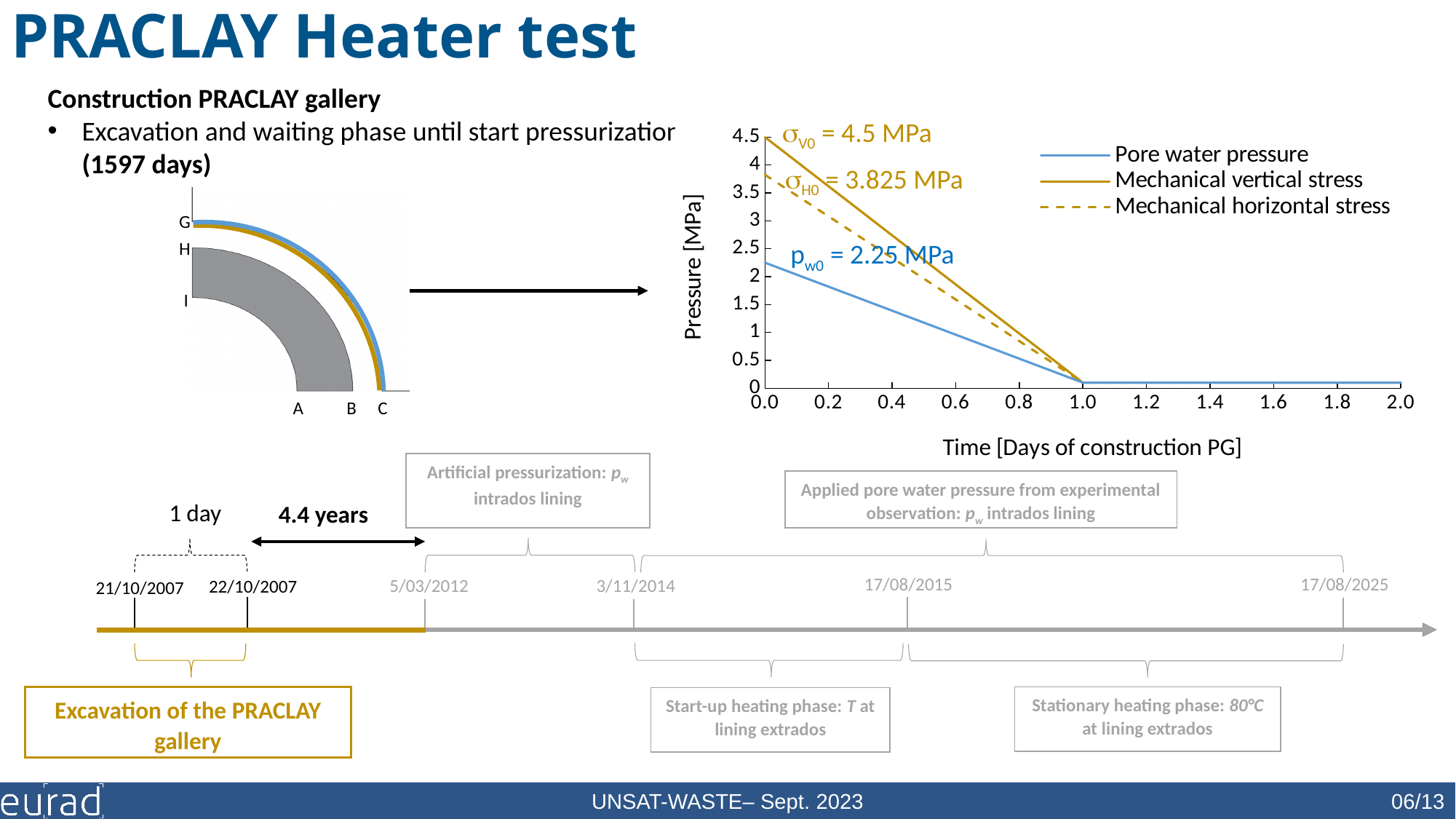
What is the initial value of the mechanical horizontal stress at time 0.0 in the pressure chart? 3.825 MPa What is the difference between the initial mechanical vertical stress and the initial pore water pressure in the pressure chart? 2.25 MPa What is the initial value of the mechanical vertical stress at time 0.0 in the pressure chart? 4.5 MPa What type of chart is shown on the right of the slide? line chart What is the initial pore water pressure at time 0.0 in the pressure chart? 2.25 MPa What is the label of the x axis of the pressure chart? Time [Days of construction PG] What is the difference between the initial mechanical vertical stress and the initial mechanical horizontal stress in the pressure chart? 0.675 MPa At time 0.0, is the mechanical horizontal stress or the pore water pressure larger in the pressure chart? Mechanical horizontal stress Do the values in the pressure chart rise or fall between time 0.0 and time 1.0? fall Which series has the highest value at time 0.0 in the pressure chart? Mechanical vertical stress How many series does the legend of the pressure chart list? 3 Which series has the lowest value at time 0.0 in the pressure chart? Pore water pressure